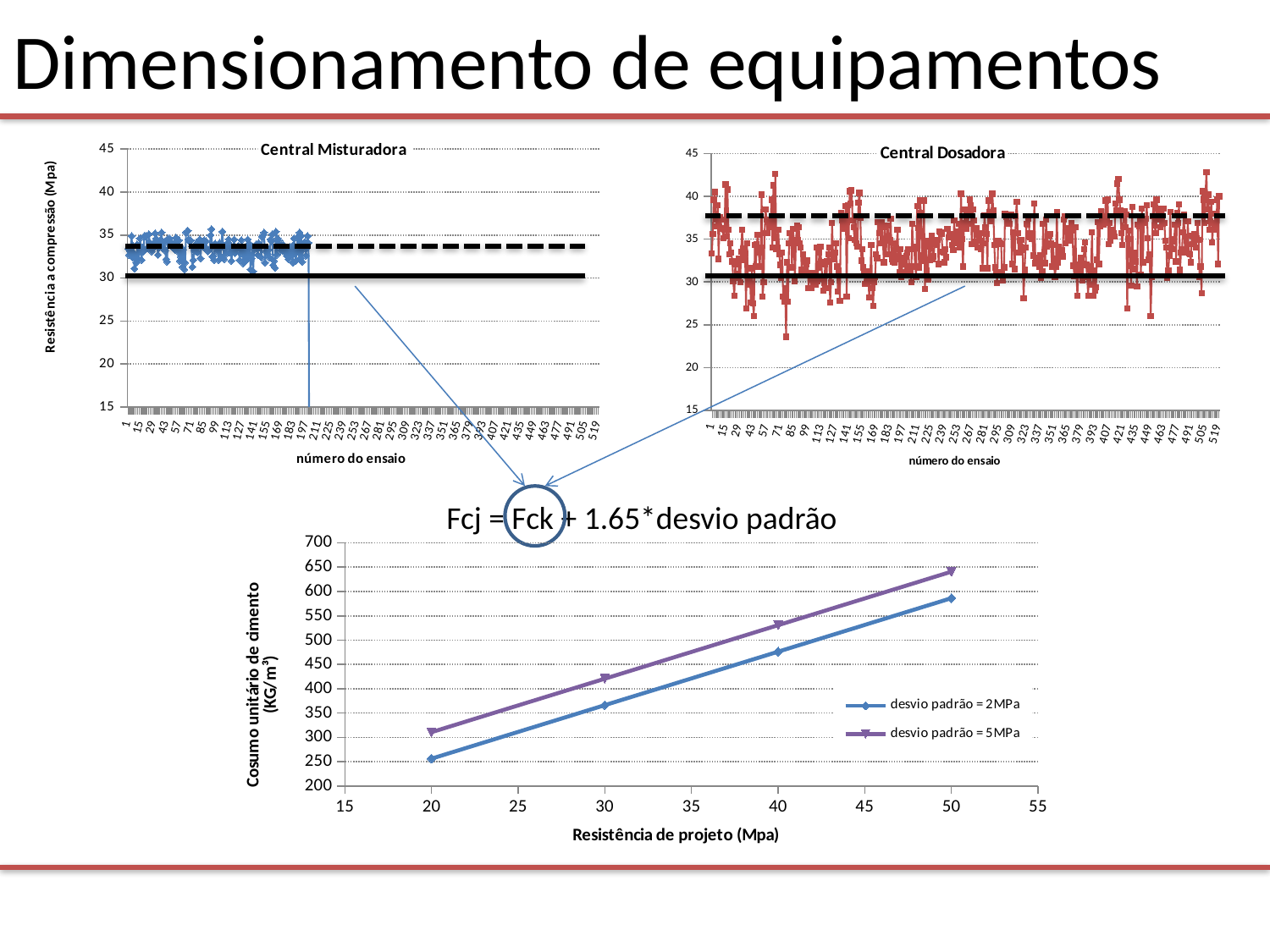
In the bottom chart, at Resistência de projeto 50, which series has the higher value: desvio padrão = 2MPa or desvio padrão = 5MPa? desvio padrão = 5MPa How many series does the legend of the bottom chart list? 2 In the bottom chart, is the value for desvio padrão = 5MPa at Resistência de projeto 20 greater or less than 350? less What are the two legend entries of the bottom chart? desvio padrão = 2MPa; desvio padrão = 5MPa In the bottom chart, do the values rise or fall as Resistência de projeto increases from 20 to 50? rise What is the title of the top-left chart? Central Misturadora In the Central Dosadora chart, is the lowest plotted value greater or less than 25? less In the Central Misturadora chart, is the highest plotted value greater or less than 40? less How many data points does each series in the bottom chart have? 4 What kind of chart is the bottom chart with the x axis 'Resistência de projeto (Mpa)'? line chart